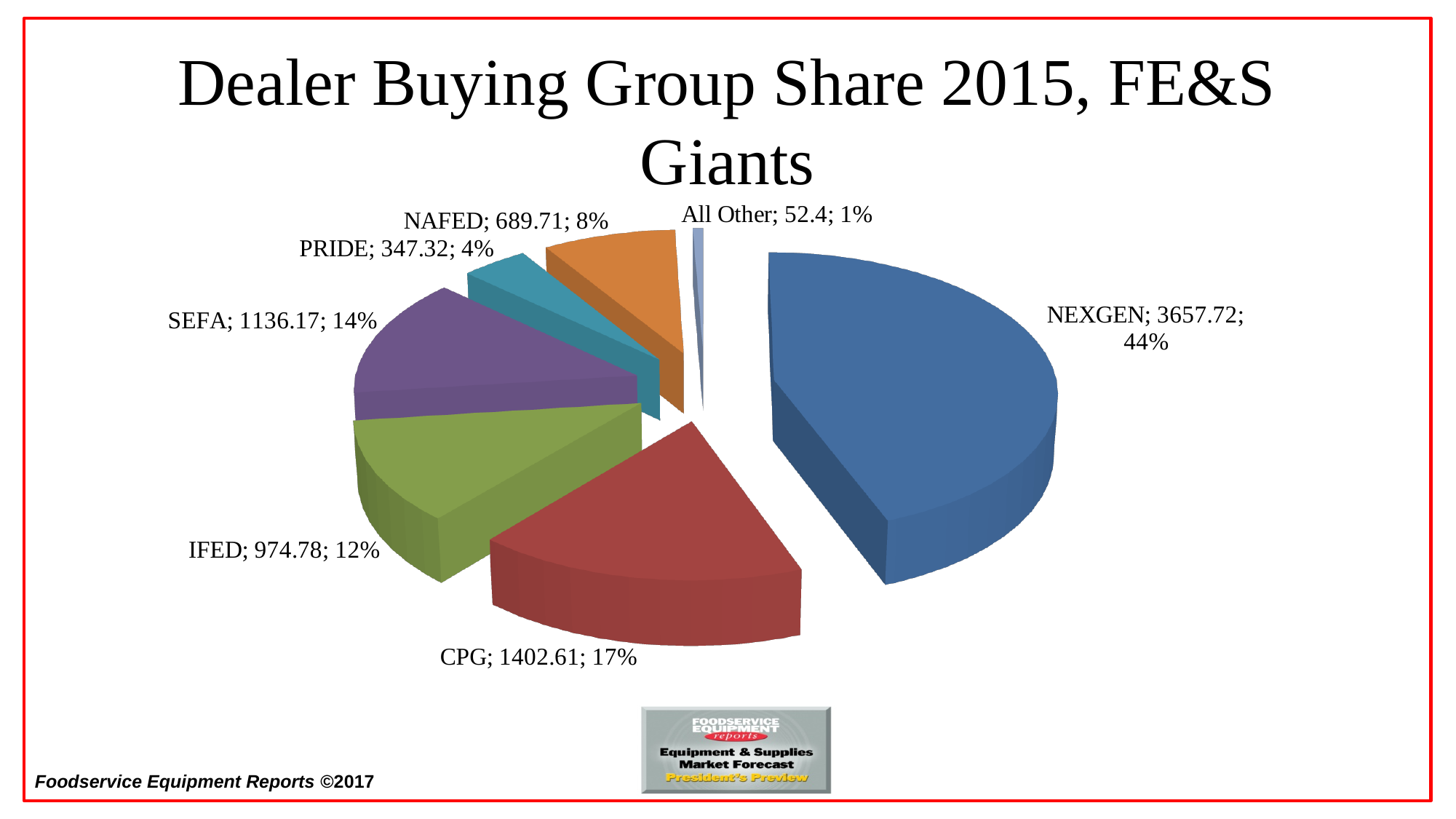
What share of the pie does NAFED hold? 8% What is the title of the chart? Dealer Buying Group Share 2015, FE&S Giants What type of chart is shown on the slide? Pie chart What share of the pie does IFED hold? 12% How many slices does the pie chart have? 7 Which category has the smallest slice? All Other What is the difference between the values for CPG and IFED? 427.83 What is the value for CPG? 1402.61 Which is larger, the value for SEFA or the value for NAFED? SEFA What is the value for NEXGEN? 3657.72 What is the value for SEFA? 1136.17 Which category has the largest slice? NEXGEN